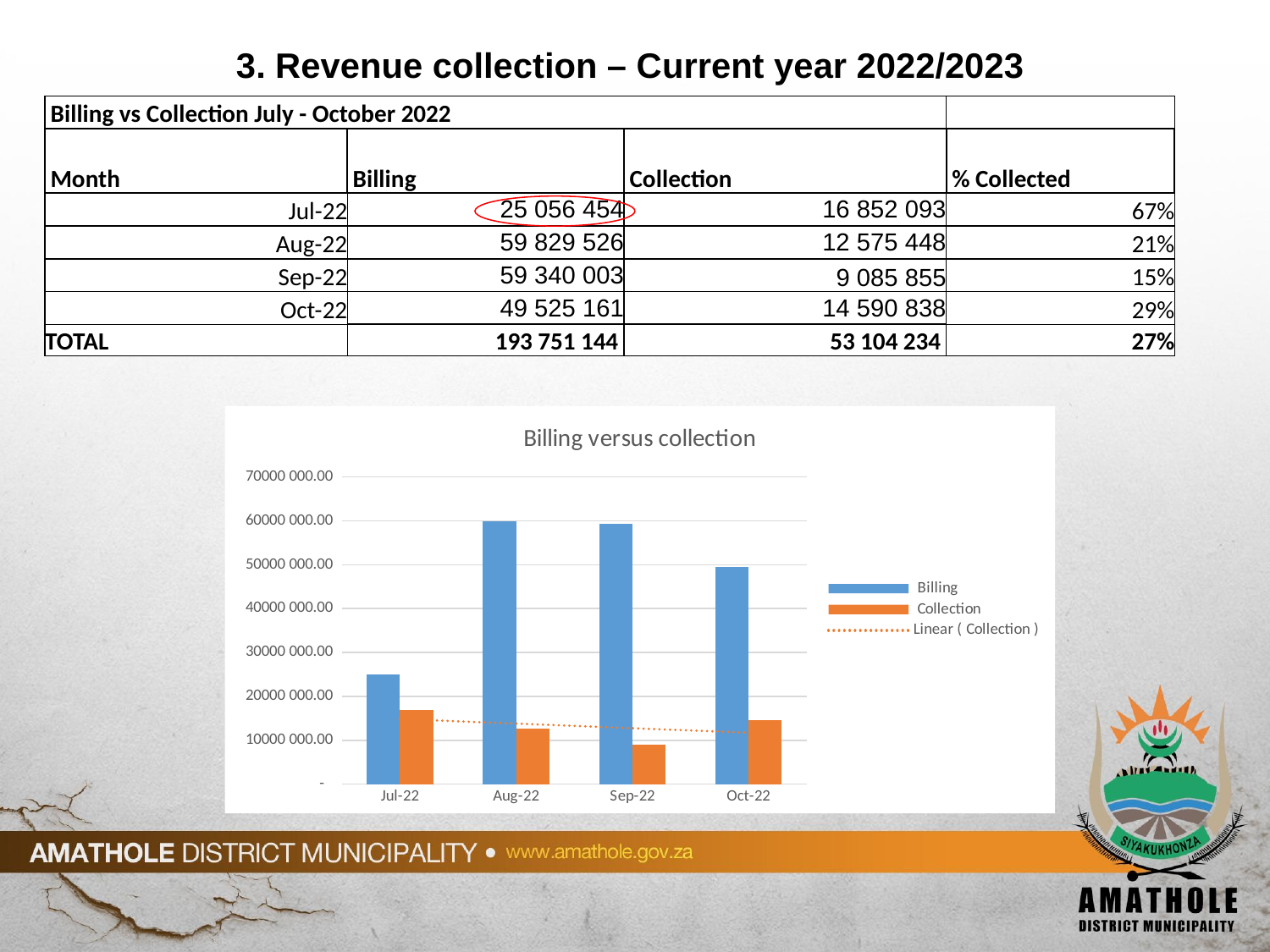
In the "Billing versus collection" chart, is the Billing value for Oct-22 greater or less than 40000 000.00? greater In the "Billing versus collection" chart, is the Billing value for Jul-22 greater or less than 30000 000.00? less How many entries does the legend of the "Billing versus collection" chart list? 3 In the "Billing versus collection" chart, is the Collection value for Sep-22 greater or less than 10000 000.00? less In the "Billing versus collection" chart, which month has the highest Collection bar? Jul-22 In the "Billing versus collection" chart, which month has the lowest Billing bar? Jul-22 Does the dotted Linear (Collection) trend line in the "Billing versus collection" chart rise or fall from Jul-22 to Oct-22? fall What kind of chart is the "Billing versus collection" chart? bar chart What is the title of the chart on the slide? Billing versus collection In the "Billing versus collection" chart, which is larger for Aug-22, Billing or Collection? Billing How many months are shown on the x axis of the "Billing versus collection" chart? 4 In the "Billing versus collection" chart, which month has the lowest Collection bar? Sep-22